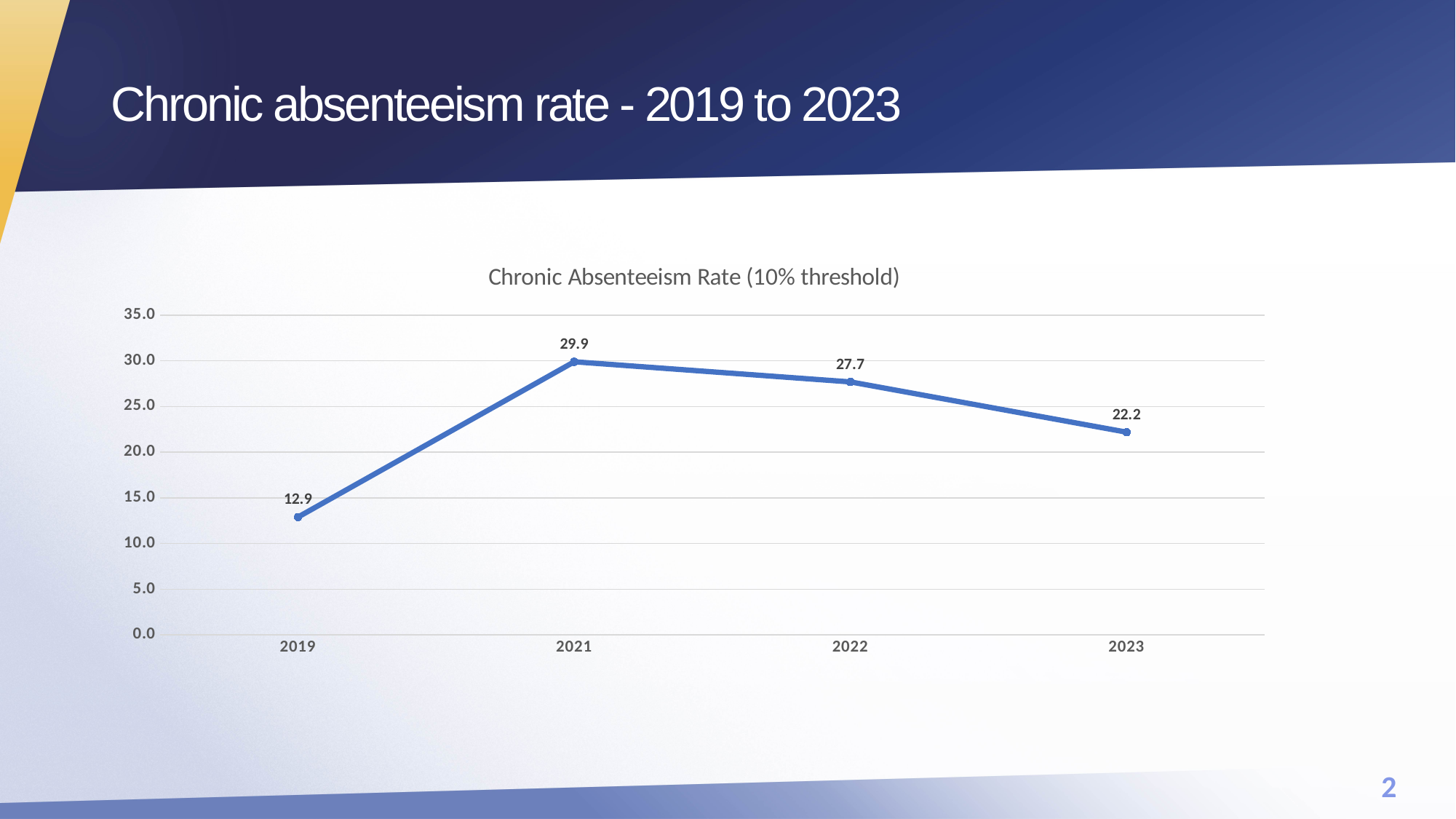
Which year has the highest chronic absenteeism rate? 2021 What is the chronic absenteeism rate for 2021? 29.9 Which year has a higher chronic absenteeism rate, 2022 or 2023? 2022 What is the chronic absenteeism rate for 2019? 12.9 What is the chronic absenteeism rate for 2022? 27.7 What kind of chart is shown on the slide? Line chart Which year has the lowest chronic absenteeism rate? 2019 What is the title of the chart? Chronic Absenteeism Rate (10% threshold) What is the difference between the chronic absenteeism rate in 2022 and in 2023? 5.5 What is the chronic absenteeism rate for 2023? 22.2 What is the difference between the chronic absenteeism rate in 2021 and in 2019? 17.0 How many years are plotted on the chart? 4